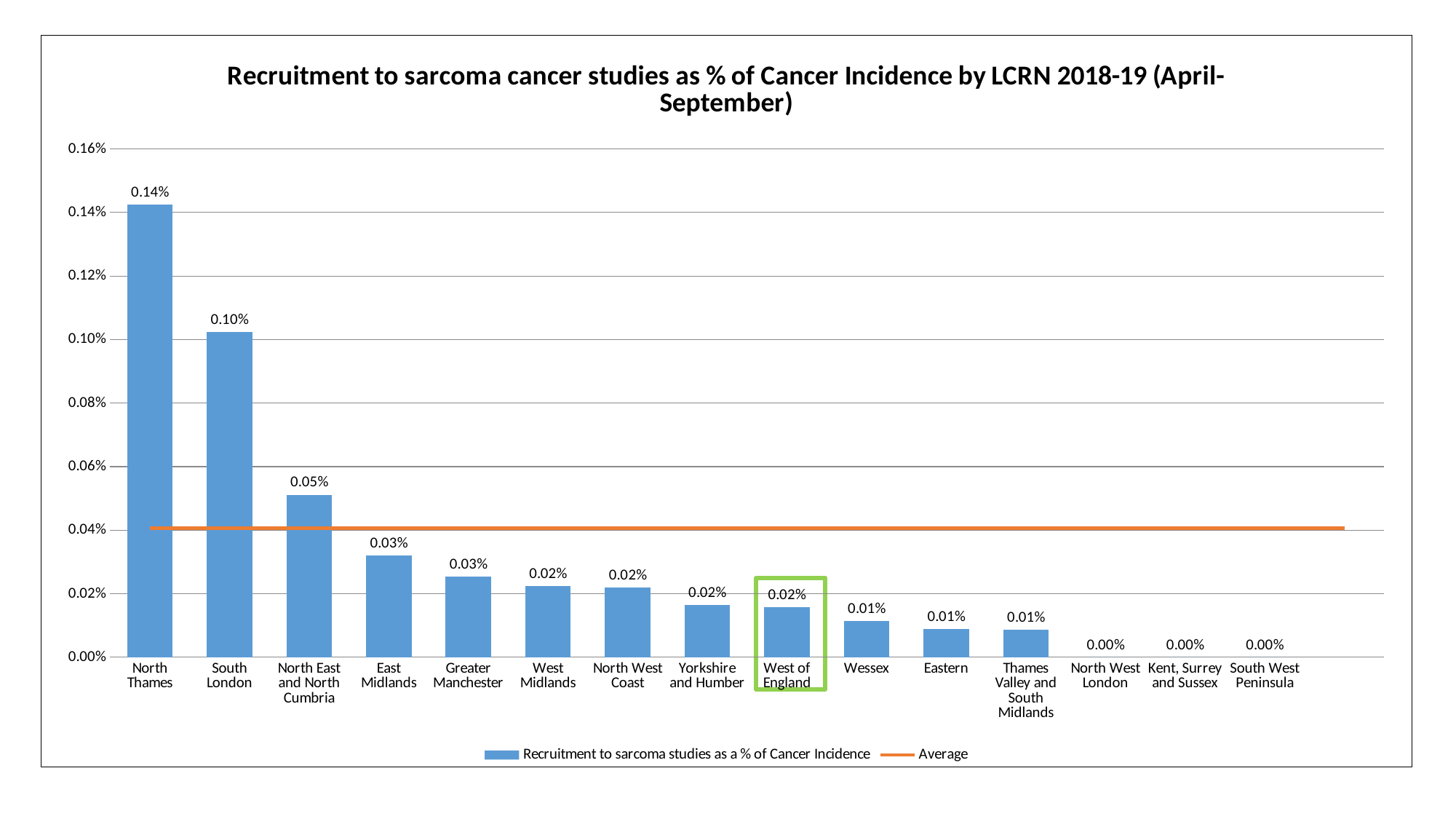
What is the value for Wessex? 0.01% How many series does the legend list? 2 What is the value for North Thames? 0.14% What kind of chart is this? Bar chart What is the difference between the values for North Thames and South London? 0.04% What is the value for South London? 0.10% Is the value for North Thames greater or less than 0.12%? greater Do the bar values rise or fall from left to right along the x axis? Fall How many LCRNs are shown on the x axis? 15 Which is larger, the value for South London or the value for East Midlands? South London What is the value for North East and North Cumbria? 0.05% Which LCRN has the highest recruitment as a % of cancer incidence? North Thames